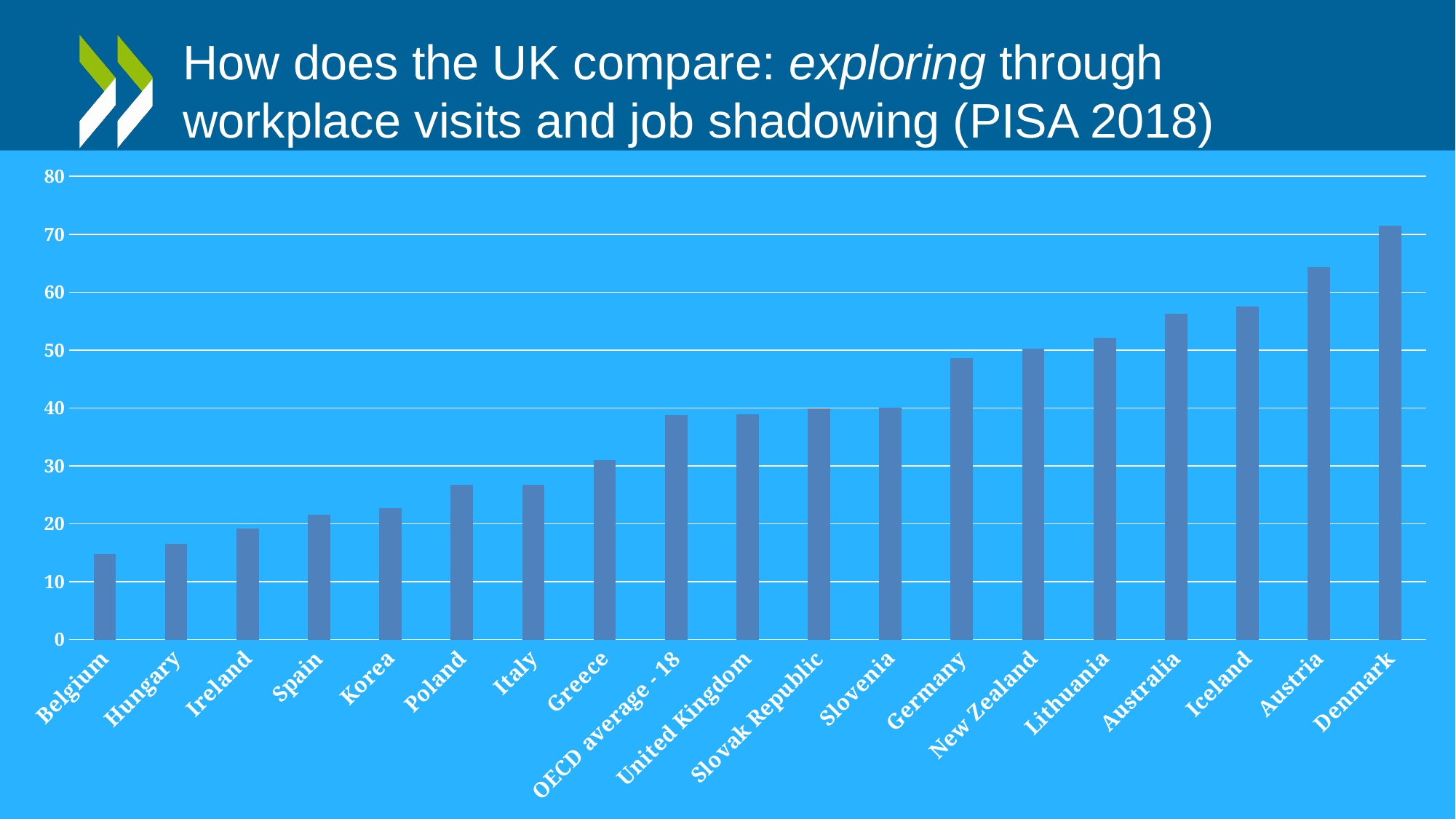
Do the bar values rise or fall from left to right along the x axis? rise Which is larger, the value for Spain or the value for Lithuania? Lithuania Is the value for Denmark greater or less than 60? greater Is the value for Australia greater or less than 50? greater Is the value for Belgium greater or less than 20? less What is the title of the slide containing the chart? How does the UK compare: exploring through workplace visits and job shadowing (PISA 2018) What kind of chart is shown on the slide? bar chart How many categories are shown on the x axis? 19 Which country has the highest bar? Denmark Which is larger, the value for Austria or the value for Germany? Austria Which country has the lowest bar? Belgium